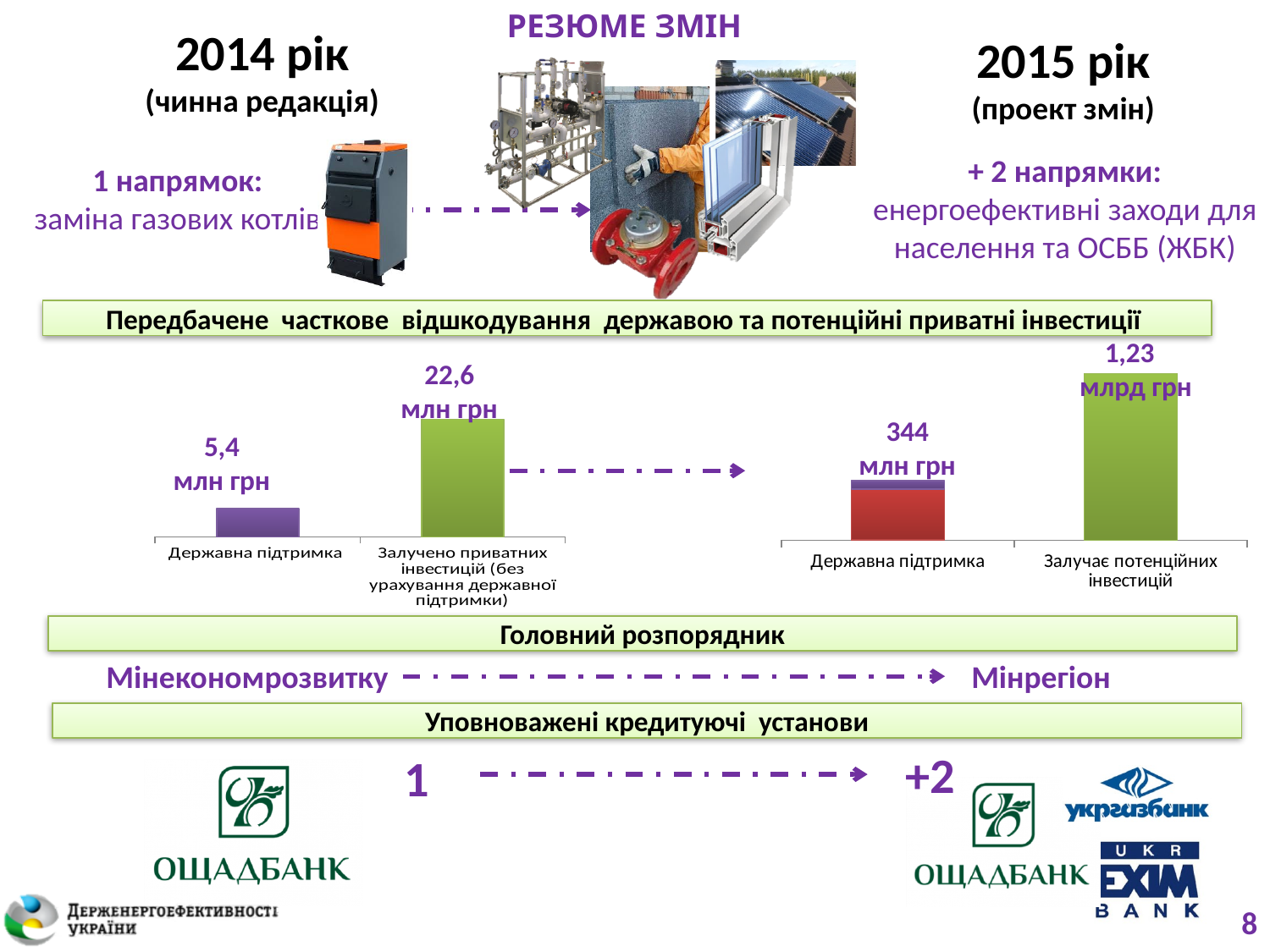
On the left chart (2014 рік), what is the value for Залучено приватних інвестицій (без урахування державної підтримки)? 22,6 млн грн On the left chart (2014 рік), what colour is the bar for Державна підтримка? Purple How many categories are shown on the left chart (2014 рік)? 2 How many categories are shown on the right chart (2015 рік)? 2 On the right chart (2015 рік), which category has the lowest value? Державна підтримка On the left chart (2014 рік), what is the difference between Залучено приватних інвестицій and Державна підтримка? 17,2 млн грн On the left chart (2014 рік), which category has the highest value? Залучено приватних інвестицій (без урахування державної підтримки) On the right chart (2015 рік), what is the value for Залучає потенційних інвестицій? 1,23 млрд грн On the right chart (2015 рік), which is larger: Державна підтримка or Залучає потенційних інвестицій? Залучає потенційних інвестицій On the right chart (2015 рік), what is the value for Державна підтримка? 344 млн грн On the left chart (2014 рік), what is the value for Державна підтримка? 5,4 млн грн What kind of chart is the left chart (2014 рік)? Bar chart